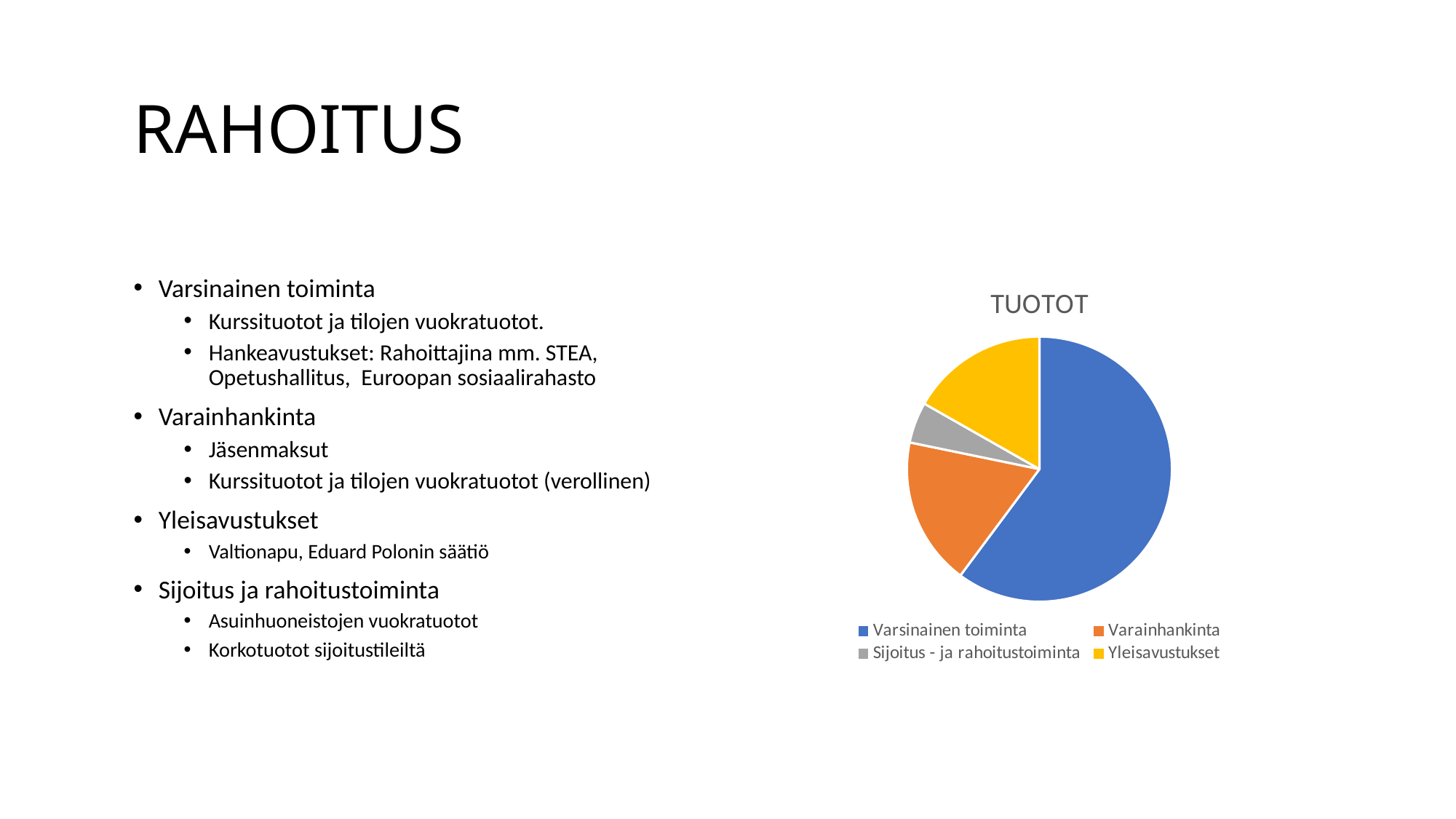
How many entries does the legend of the pie chart list? 4 Which slice is larger in the pie chart, Yleisavustukset or Sijoitus - ja rahoitustoiminta? Yleisavustukset Which slice is larger in the pie chart, Varsinainen toiminta or Varainhankinta? Varsinainen toiminta What kind of chart is shown on the slide? pie chart How many slices does the pie chart have? 4 Which category has the largest slice in the pie chart? Varsinainen toiminta Which slice is larger in the pie chart, Varainhankinta or Yleisavustukset? Varainhankinta Which colour represents Yleisavustukset in the pie chart? yellow Which category has the smallest slice in the pie chart? Sijoitus - ja rahoitustoiminta What is the title of the chart on the slide? TUOTOT